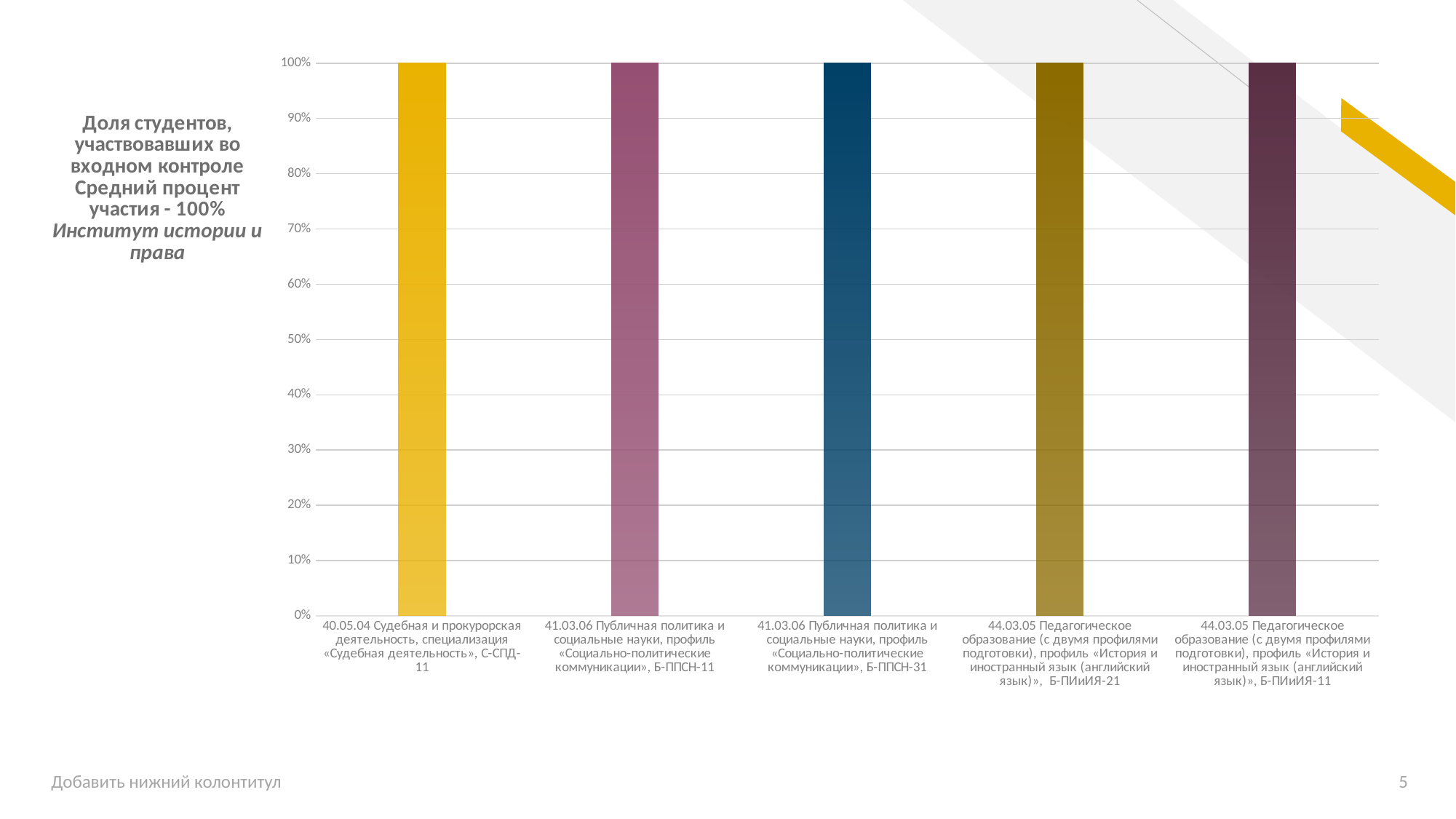
What type of chart is shown on the slide? bar chart According to the text on the slide, what is the average participation percentage (Средний процент участия)? 100% Do the values rise, fall, or stay the same across the categories along the x axis? stay the same How many bars (categories) are plotted in the chart? 5 What is the value for the group Б-ПИиИЯ-11? 100% What is the highest value shown on the vertical axis? 100% What is the value for the group Б-ППСН-11? 100% What is the value for the group С-СПД-11 (40.05.04 Судебная и прокурорская деятельность)? 100% What is the value for the group Б-ПИиИЯ-21? 100% What is the value for the group Б-ППСН-31? 100% Is the value for Б-ППСН-31 greater or less than 50%? greater What is the difference between the values for С-СПД-11 and Б-ПИиИЯ-11? 0%